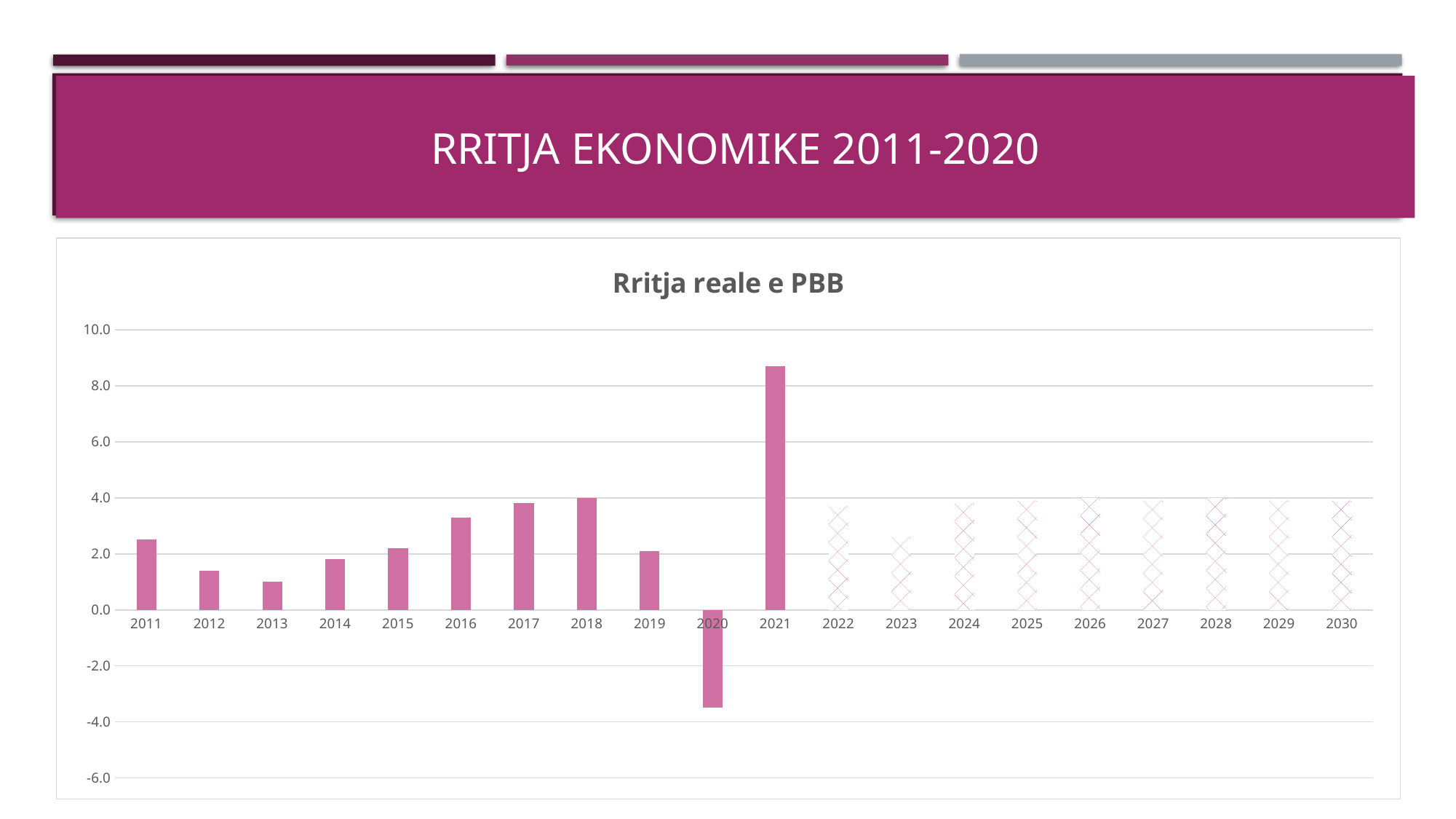
What kind of chart is shown on the slide? bar chart Do the values rise or fall from 2013 to 2018? rise Which year has the highest value in the chart? 2021 Which year has the lowest value in the chart? 2020 Is the value for 2020 greater or less than -2.0? less Which year has the larger value, 2011 or 2012? 2011 Which year has the larger value, 2016 or 2019? 2016 Is the value for 2017 greater or less than 2.0? greater Is the value for 2013 greater or less than 2.0? less How many years are shown on the x axis of the chart? 20 What is the title of the chart? Rritja reale e PBB